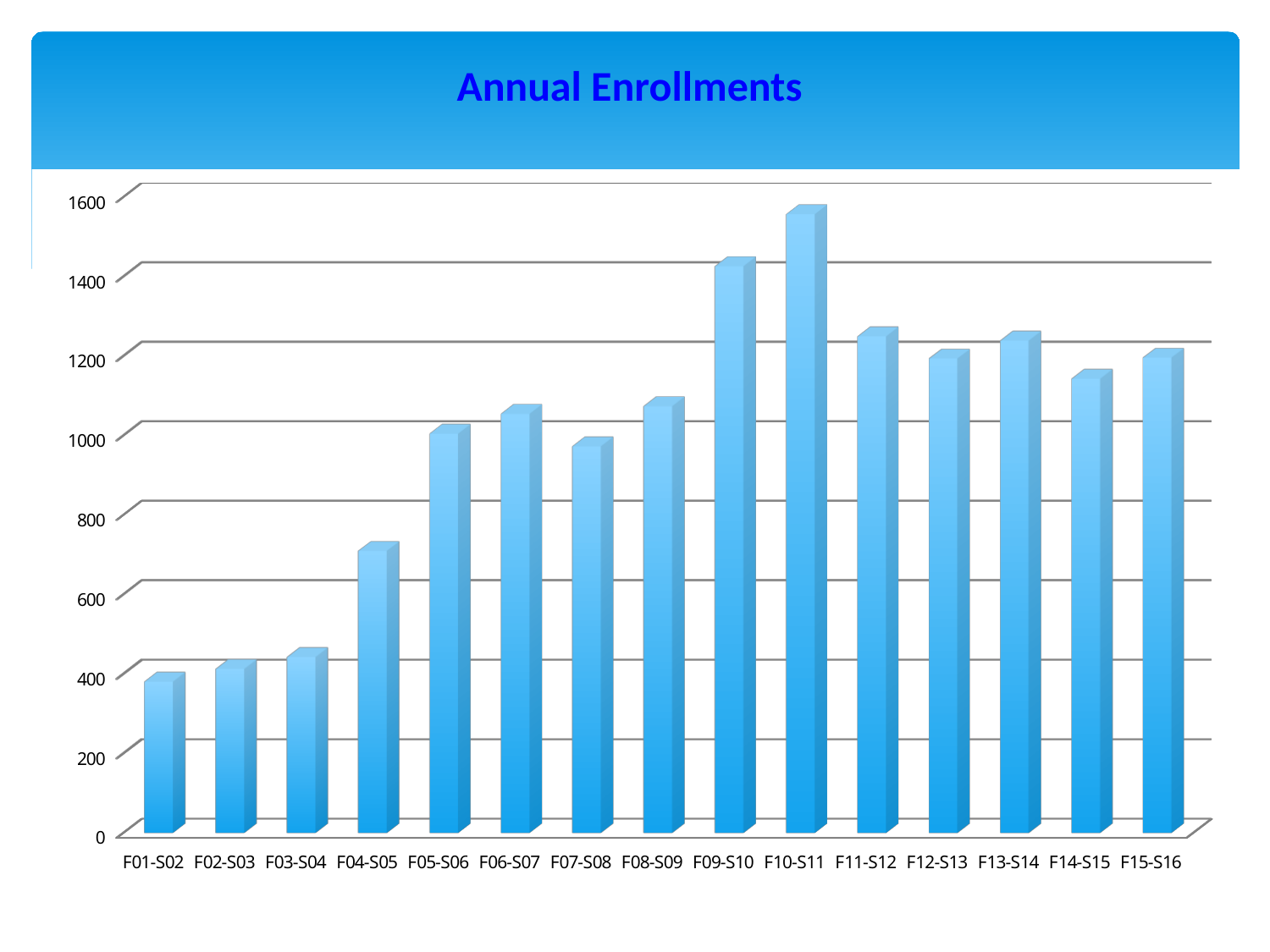
Which academic year has the highest enrollment? F10-S11 Is the value for F01-S02 greater or less than 600? less What is the title of the chart? Annual Enrollments Is the value for F04-S05 greater or less than 800? less What kind of chart is shown on the slide? bar chart Do enrollments generally rise or fall from F01-S02 to F10-S11? rise Is the value for F10-S11 greater or less than 1400? greater How many academic years (categories) are plotted on the x axis? 15 Which is larger, the enrollment for F09-S10 or for F10-S11? F10-S11 Which is larger, the enrollment for F04-S05 or for F05-S06? F05-S06 Which academic year has the lowest enrollment? F01-S02